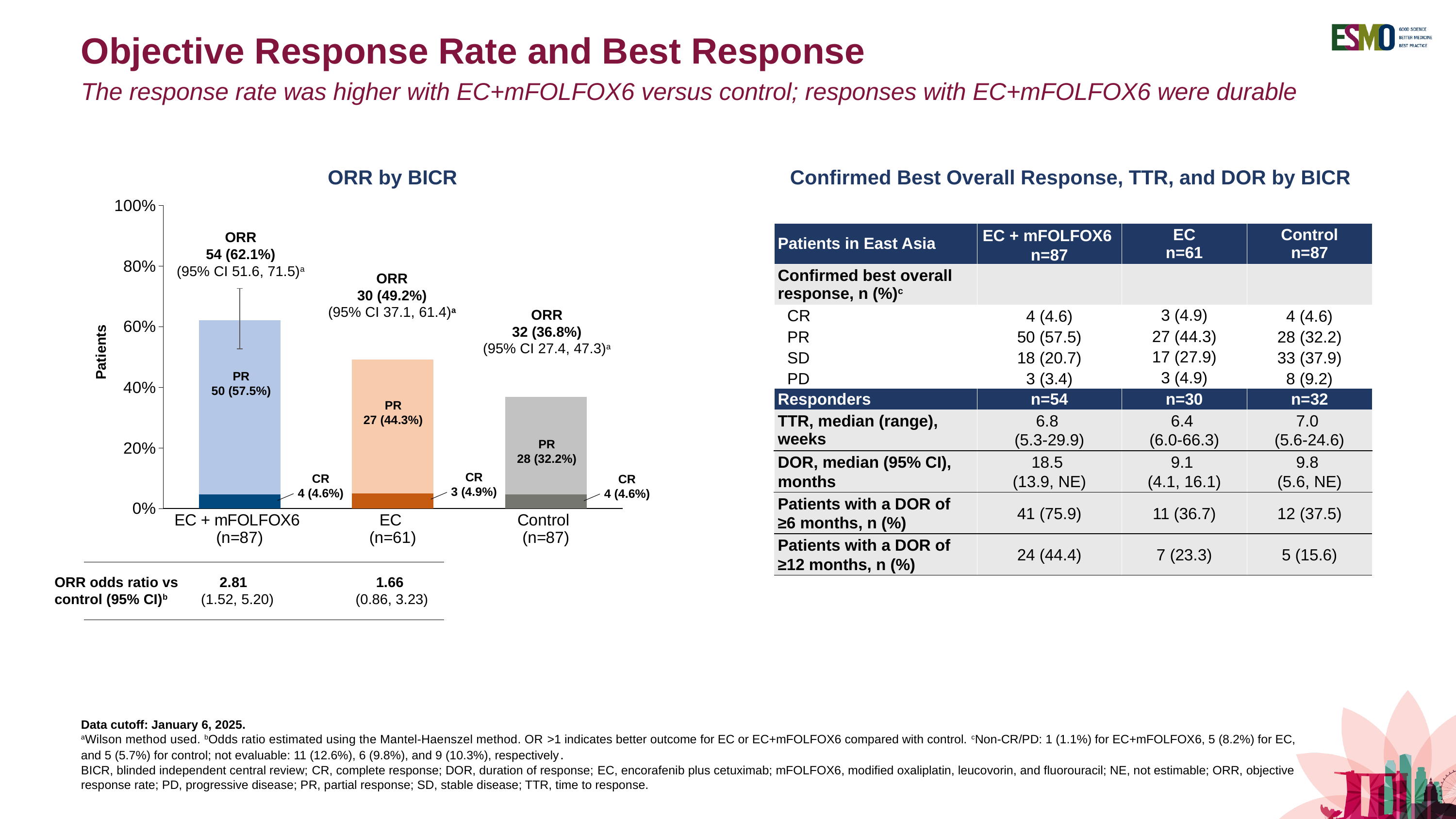
In the ORR by BICR chart, which has the larger PR percentage, EC or Control? EC In the ORR by BICR chart, which treatment arm has the highest ORR? EC + mFOLFOX6 In the ORR by BICR chart, what is the CR value labelled for the EC bar? 3 (4.9%) In the ORR by BICR chart, what is the PR value labelled for the EC + mFOLFOX6 bar? 50 (57.5%) In the ORR by BICR chart, what ORR is labelled above the Control bar? 32 (36.8%) In the ORR by BICR chart, what is the difference in ORR percentage between EC + mFOLFOX6 (62.1%) and Control (36.8%)? 25.3 percentage points In the ORR by BICR chart, is the total height of the EC bar greater or less than 40%? greater How many treatment arms are shown on the x axis of the ORR by BICR chart? 3 In the ORR by BICR chart, what is the total ORR count for the EC bar (CR 3 plus PR 27)? 30 In the ORR by BICR chart, what is the ORR odds ratio vs control shown for EC + mFOLFOX6? 2.81 What kind of chart is the ORR by BICR chart? Stacked bar chart In the ORR by BICR chart, which treatment arm has the lowest ORR? Control